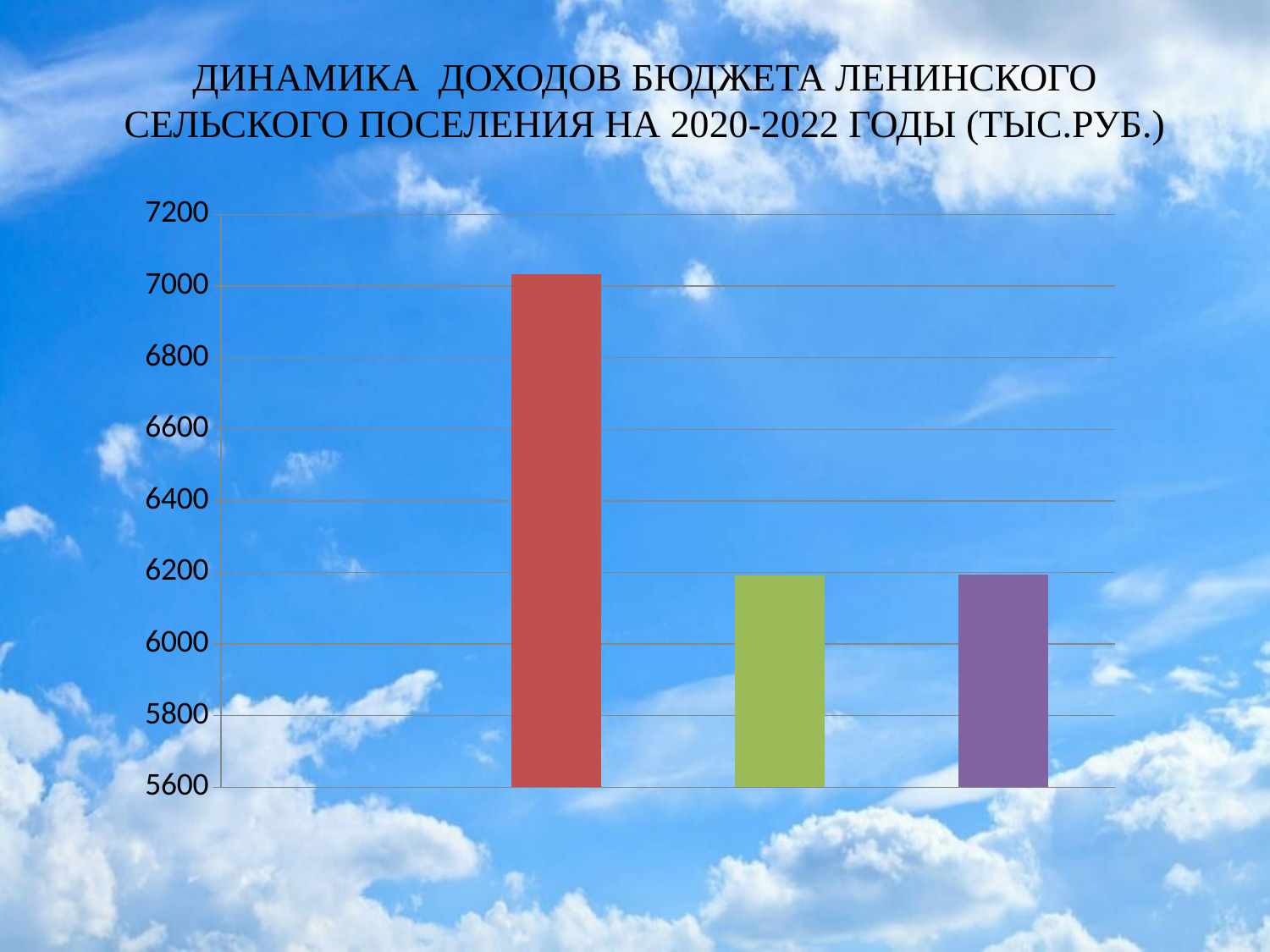
Does the value rise or fall from the first bar to the second bar? fall What kind of chart is shown on the slide? bar chart Which is larger, the red (first) bar or the green (second) bar? the red (first) bar What is the highest value shown on the vertical axis? 7200 What unit is given in the chart title? ТЫС.РУБ. Is the value of the purple (third) bar greater or less than 6400? less Which bar is the highest in the chart? the red bar (first bar) Is the value of the green (second) bar greater or less than 6600? less Which is larger, the red (first) bar or the purple (third) bar? the red (first) bar Is the value of the green (second) bar greater or less than 6000? greater How many bars are plotted in the chart? 3